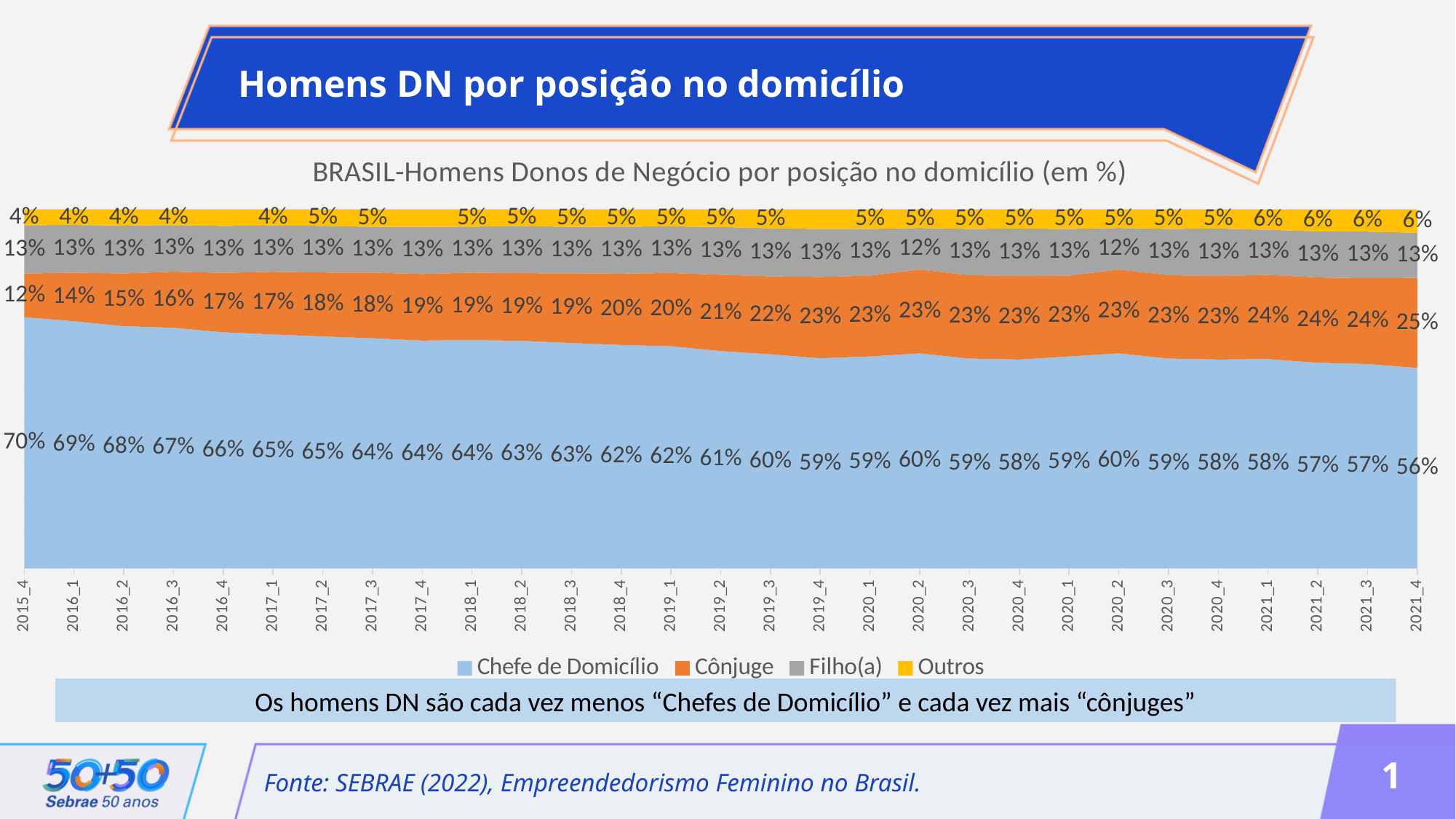
Which series has the smallest value at 2015_4? Outros What kind of chart is shown on the slide? Stacked area chart What is the value for Chefe de Domicílio at 2015_4? 70% What is the title of the chart? BRASIL-Homens Donos de Negócio por posição no domicílio (em %) By how many percentage points did Chefe de Domicílio change between 2015_4 (70%) and 2021_4 (56%)? 14 percentage points Does the share of Chefe de Domicílio rise or fall from 2015_4 to 2021_4? Fall At 2021_4, which is larger: Cônjuge or Filho(a)? Cônjuge What is the value for Outros at 2021_4? 6% How many series does the legend list? 4 Does the share of Cônjuge rise or fall from 2015_4 to 2021_4? Rise What is the value for Chefe de Domicílio at 2021_4? 56% What is the value for Cônjuge at 2021_4? 25%